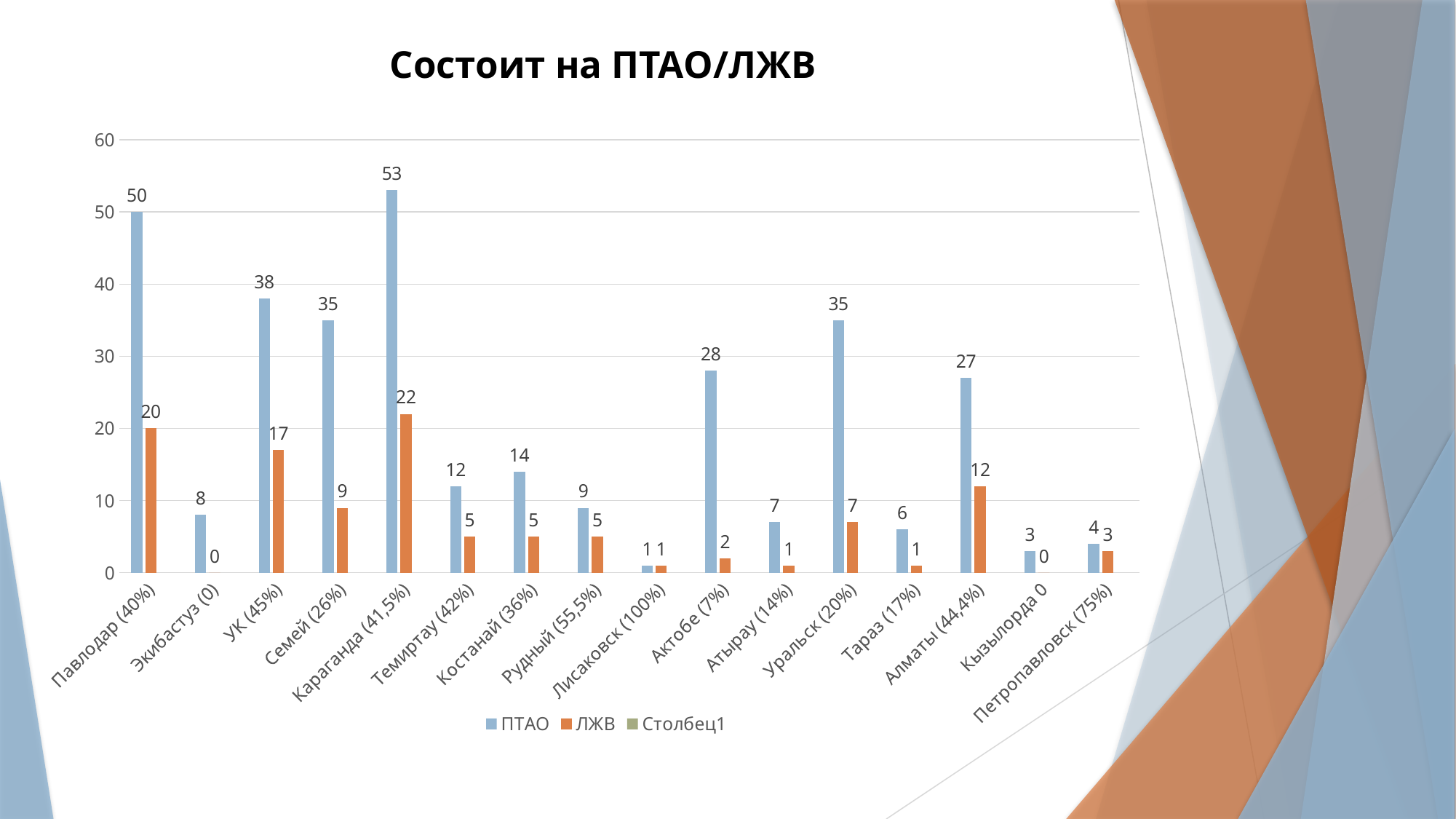
Which is larger: the ПТАО value for УК (45%) or the ПТАО value for Семей (26%)? УК (45%) Which colour represents the ЛЖВ series? Orange How many categories are shown on the x axis? 16 What is the difference between the ПТАО and ЛЖВ values for Караганда (41,5%)? 31 What kind of chart is shown on the slide? Bar chart Which category has the highest ПТАО value? Караганда (41,5%) What is the ЛЖВ value for Алматы (44,4%)? 12 What is the ПТАО value for Павлодар (40%)? 50 How many series does the legend list? 3 What is the title of the chart? Состоит на ПТАО/ЛЖВ Which category has the lowest ПТАО value? Лисаковск (100%) What is the ЛЖВ value for Уральск (20%)? 7